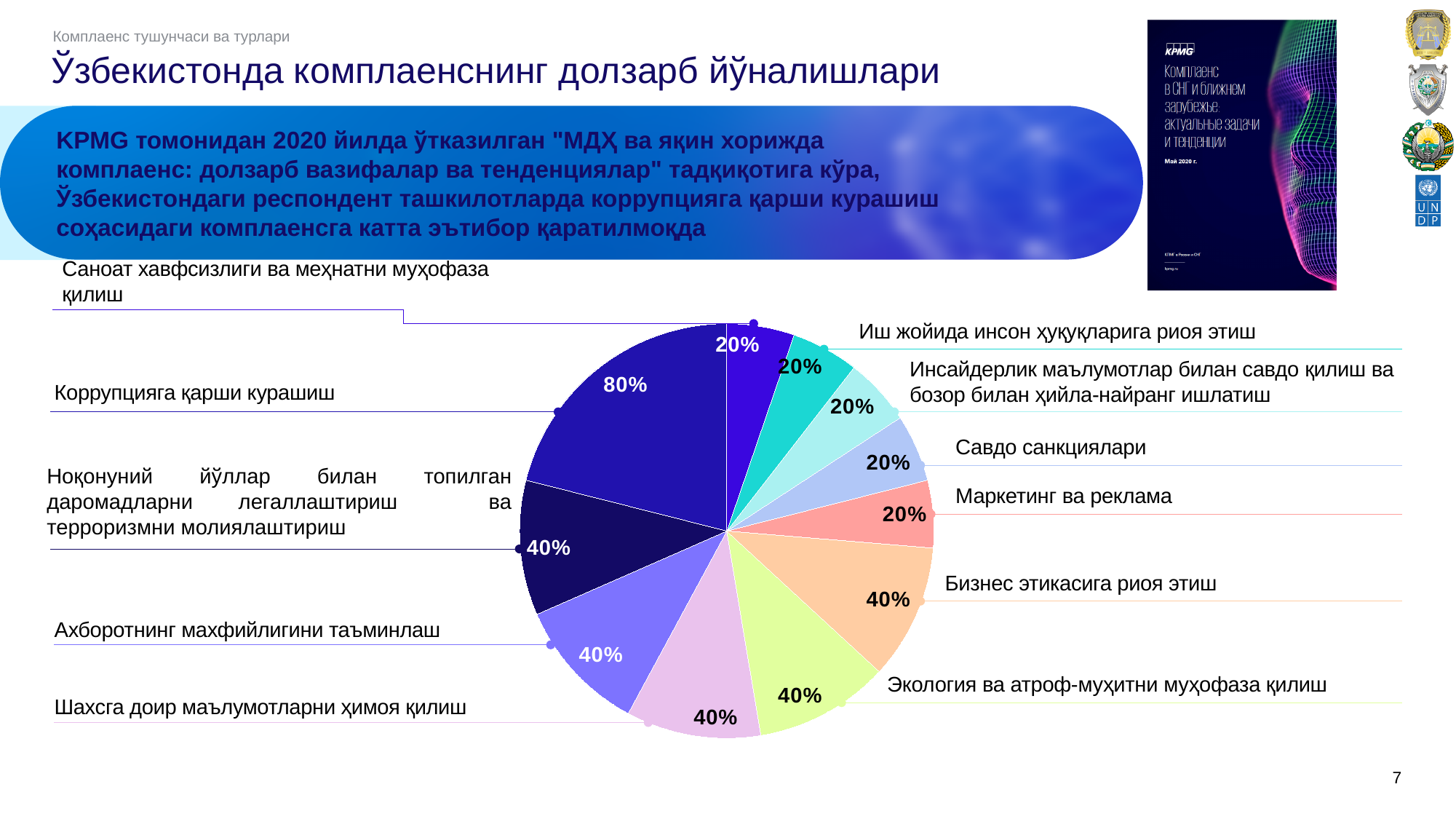
How many slices does the pie chart have? 11 Which is larger: the value for Экология ва атроф-муҳитни муҳофаза қилиш or the value for Иш жойида инсон ҳуқуқларига риоя этиш? Экология ва атроф-муҳитни муҳофаза қилиш What kind of chart is shown on the slide? pie chart What is the title of the slide containing the pie chart? Ўзбекистонда комплаенснинг долзарб йўналишлари Which category has the largest slice in the pie chart? Коррупцияга қарши курашиш What value is shown for Савдо санкциялари? 20% What value is shown for Бизнес этикасига риоя этиш? 40% What is the difference between the value for Коррупцияга қарши курашиш and the value for Шахсга доир маълумотларни ҳимоя қилиш? 40% How many slices in the pie chart are labelled 20%? 5 What value is shown for Ахборотнинг махфийлигини таъминлаш? 40% What value is shown for Коррупцияга қарши курашиш? 80% What value is shown for Маркетинг ва реклама? 20%